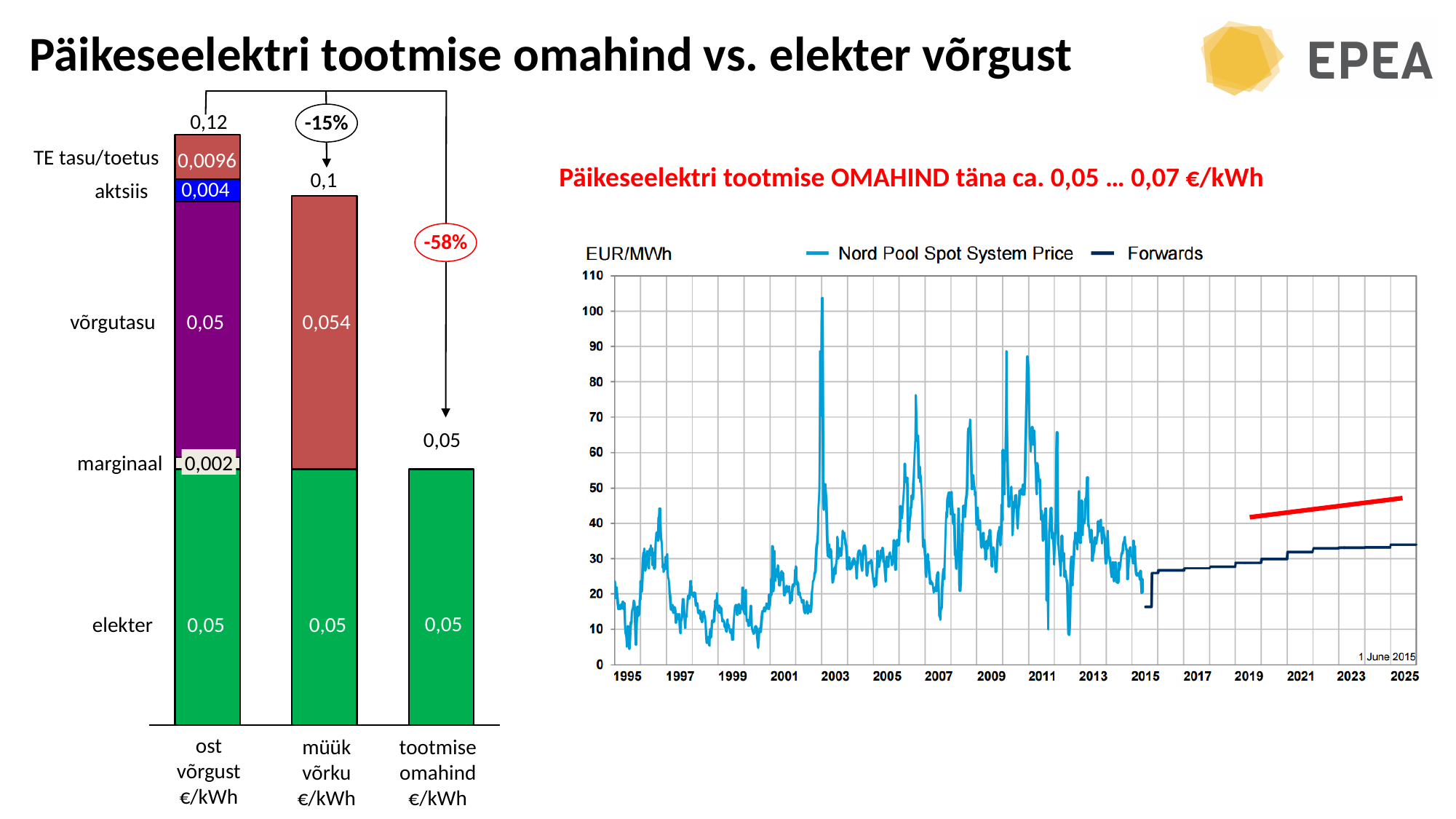
In the left chart, which bar has the highest total? ost võrgust In the right chart (Nord Pool Spot System Price), how many series does the legend list? 2 In the right chart, is the peak of the Nord Pool Spot System Price around 2002–2003 greater or less than 100? greater What kind of chart is the left chart (ost võrgust / müük võrku / tootmise omahind)? bar chart In the left chart, what is the 'võrgutasu' value in the 'ost võrgust' bar? 0,05 In the left chart, what is the total of the 'müük võrku' bar? 0,1 In the left chart, how many bars are shown? 3 In the left chart, what is the 'aktsiis' value in the 'ost võrgust' bar? 0,004 In the left chart, what is the difference between the total of 'ost võrgust' (0,12) and the total of 'tootmise omahind' (0,05)? 0,07 In the left chart, what is the 'TE tasu/toetus' value in the 'ost võrgust' bar? 0,0096 What kind of chart is the right chart (Nord Pool Spot System Price)? line chart In the left chart, what is the total of the 'ost võrgust' bar? 0,12